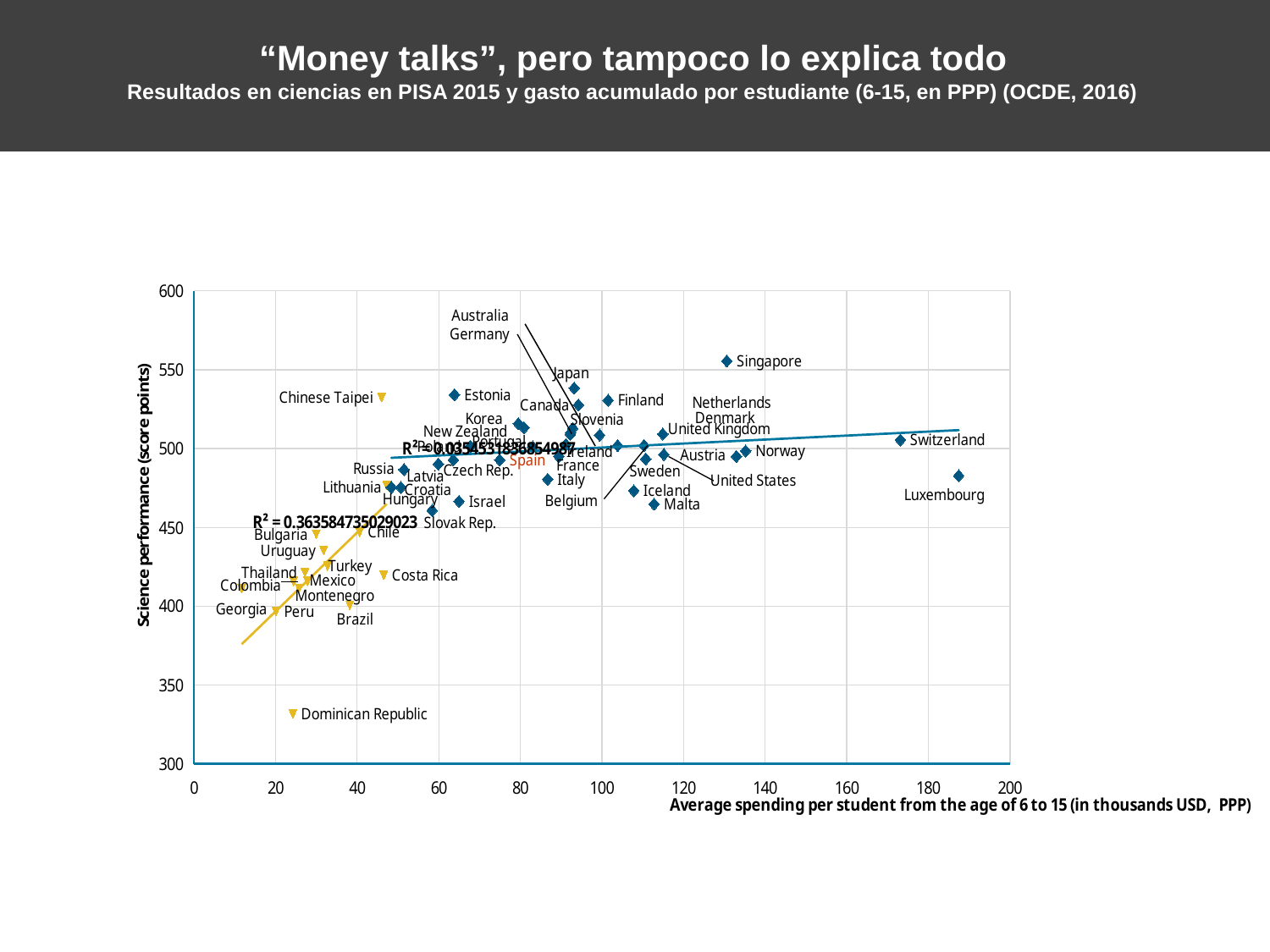
Which country has the lowest science performance on the chart? Dominican Republic Is the science performance for Dominican Republic greater or less than 350? less Which country has the highest science performance on the chart? Singapore Is the average spending per student for Luxembourg greater or less than 180? greater What R² value is printed next to the yellow trend line? R² = 0.363584735029023 Is the science performance for Brazil greater or less than 450? less What kind of chart is shown on the slide? scatter chart What is the label of the vertical axis? Science performance (score points) Which country has the highest average spending per student on the chart? Luxembourg Which has the higher average spending per student, Luxembourg or Switzerland? Luxembourg Which has the higher science performance, Singapore or Switzerland? Singapore